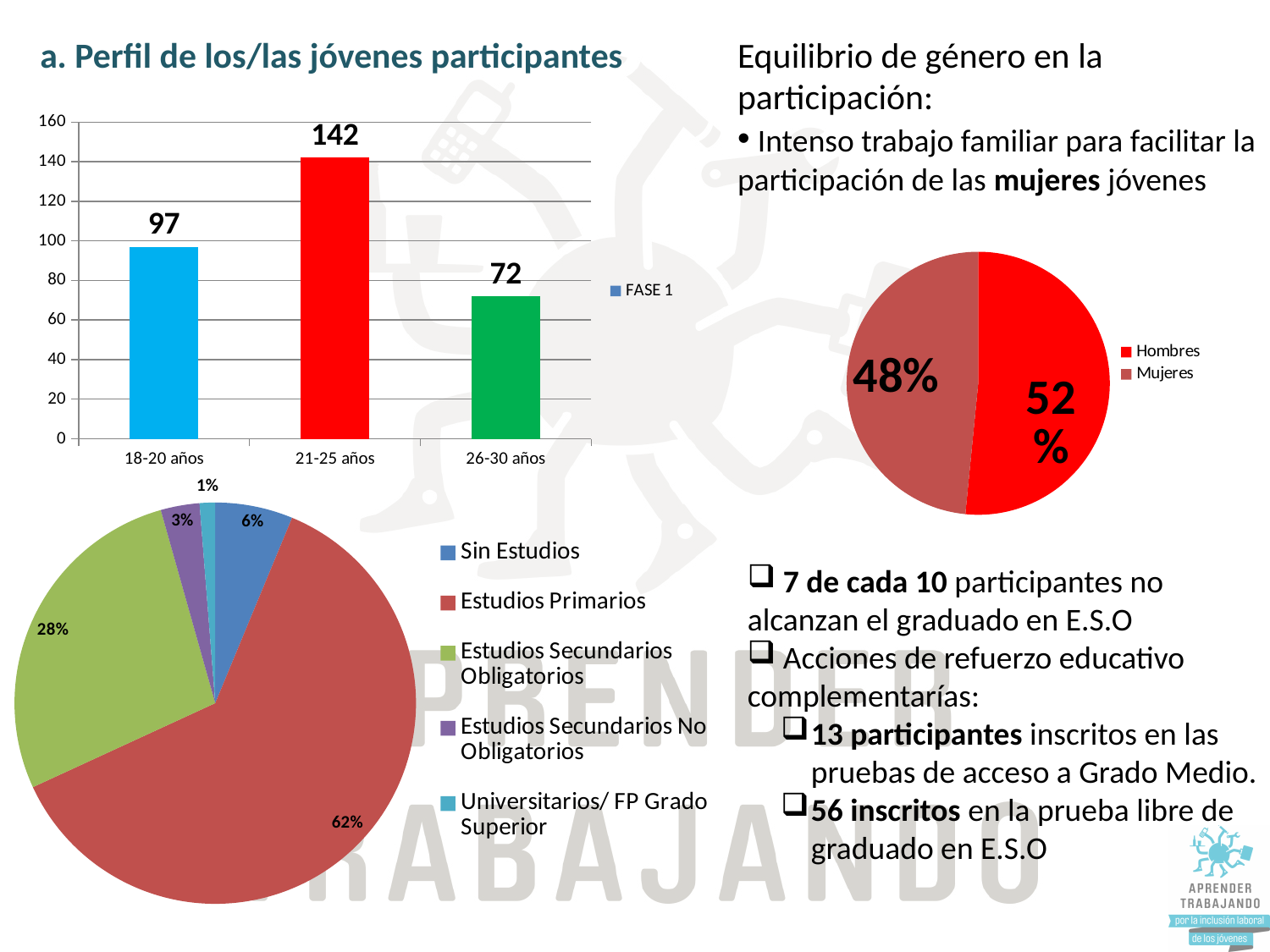
In the bar chart at the top left, what is the value for 21-25 años? 142 In the bar chart at the top left, what is the difference between the values for 21-25 años and 18-20 años? 45 In the pie chart at the bottom left, what share is Estudios Primarios? 62% In the bar chart at the top left, which age group has the highest value? 21-25 años In the pie chart at the bottom left, how many categories does the legend list? 5 In the bar chart at the top left, what is the value for 26-30 años? 72 In the bar chart at the top left, how many age categories are shown? 3 In the bar chart at the top left, which age group has the lowest value? 26-30 años What kind of chart is the chart at the top left of the slide? bar chart In the pie chart on the right, what share is Hombres? 52% In the bar chart at the top left, what series name does the legend show? FASE 1 In the pie chart on the right, which is larger, Hombres or Mujeres? Hombres